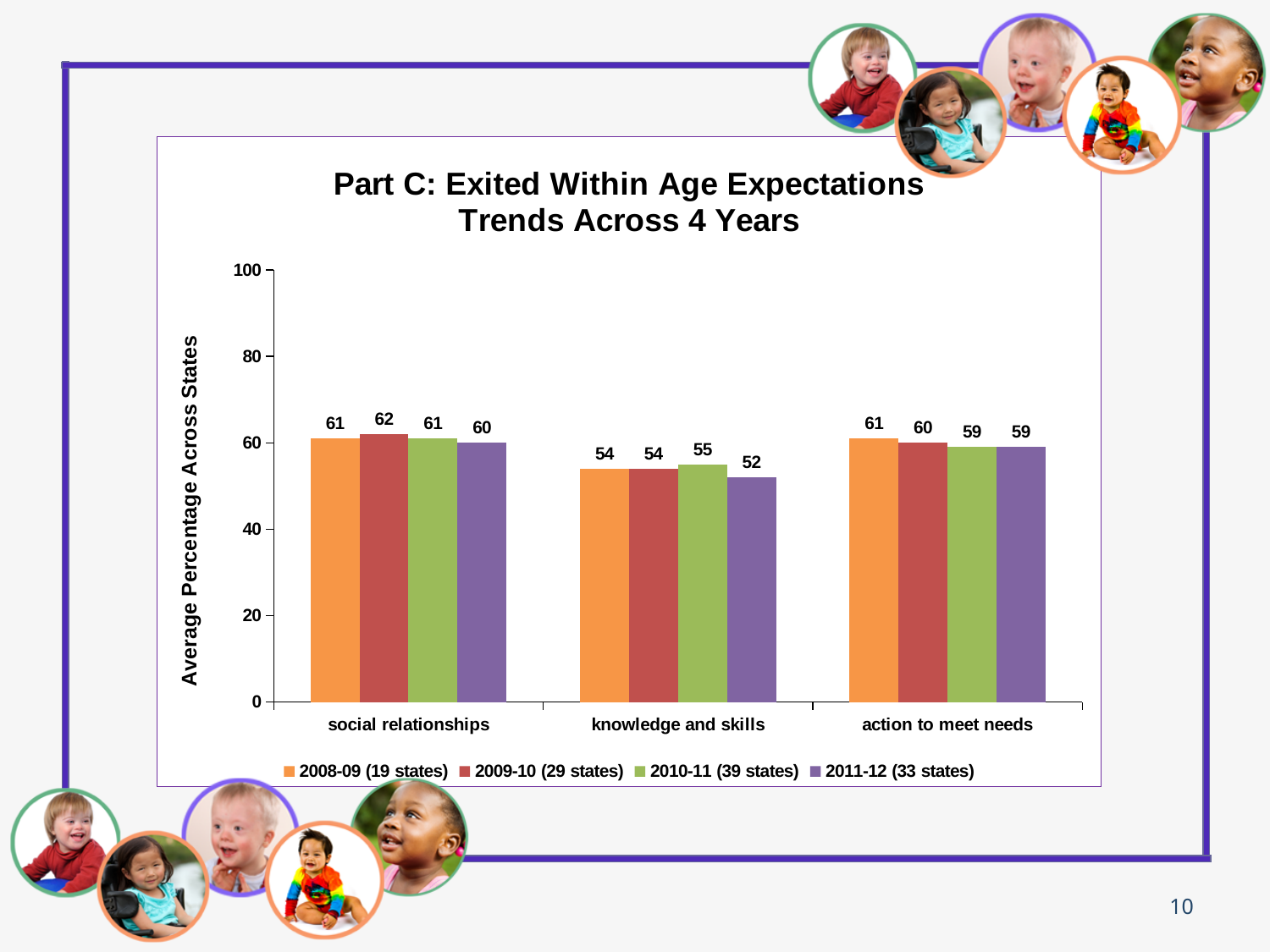
What is the difference between the 2010-11 (39 states) and 2011-12 (33 states) values for knowledge and skills? 3 How many categories are shown on the x axis? 3 What is the label of the y axis? Average Percentage Across States What kind of chart is shown on the slide? bar chart Which series has the highest value for social relationships? 2009-10 (29 states) Which is larger for action to meet needs: the 2008-09 (19 states) value or the 2010-11 (39 states) value? 2008-09 (19 states) What is the title of the chart? Part C: Exited Within Age Expectations Trends Across 4 Years How many series does the legend list? 4 What is the value for knowledge and skills in the 2011-12 (33 states) series? 52 Which category has the lowest value in the 2011-12 (33 states) series? knowledge and skills What is the value for social relationships in the 2009-10 (29 states) series? 62 What is the value for action to meet needs in the 2008-09 (19 states) series? 61